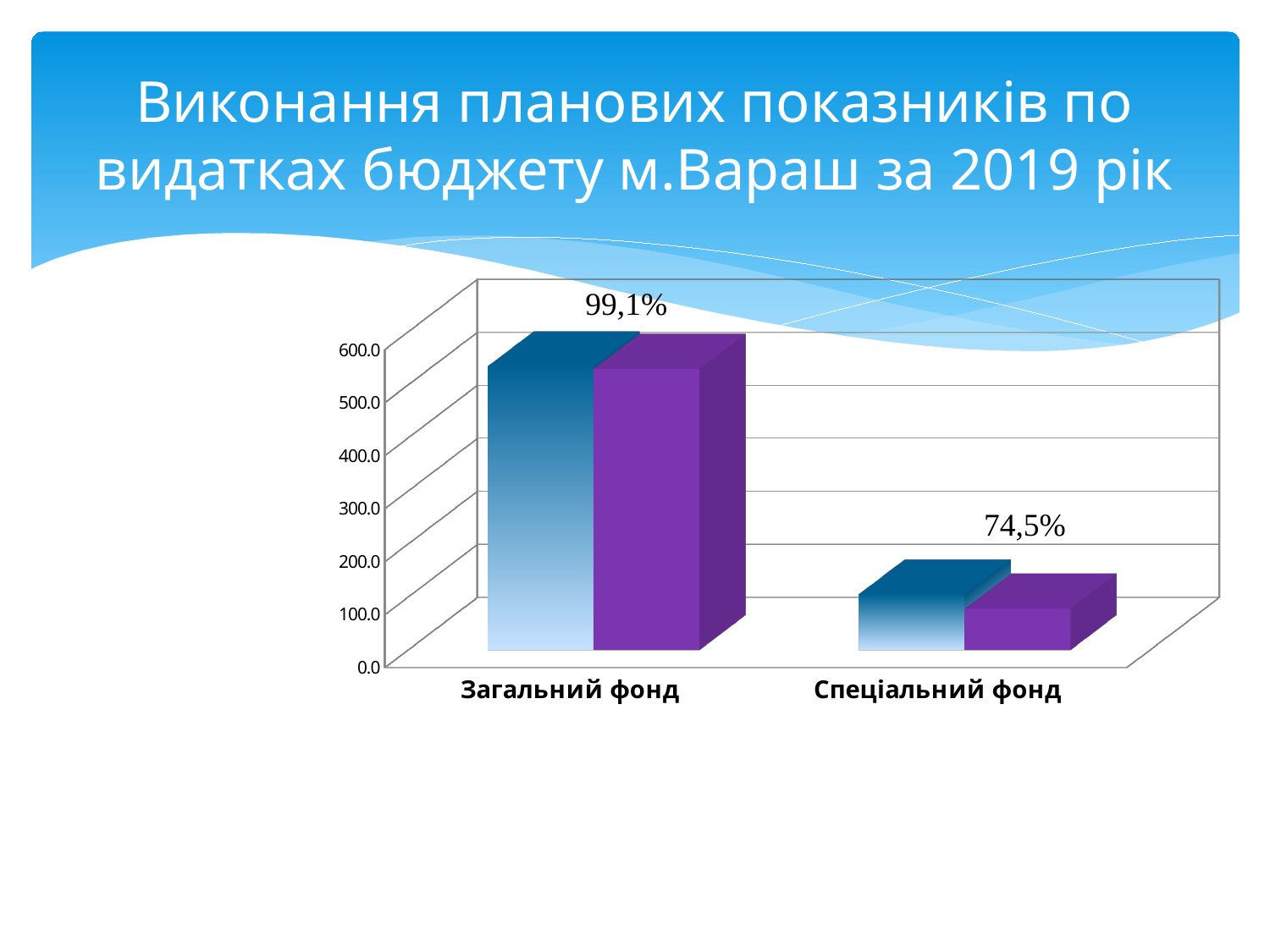
How many categories are shown on the x axis of the chart? 2 What percentage label is printed above the bars for Спеціальний фонд? 74,5% Which category has the highest bars in the chart? Загальний фонд Do the bar values rise or fall from Загальний фонд to Спеціальний фонд? fall What percentage label is printed above the bars for Загальний фонд? 99,1% Is the value of the purple bar for Спеціальний фонд greater or less than 300? less Is the value of the blue bar for Спеціальний фонд greater or less than 300? less Which category has the lowest bars in the chart? Спеціальний фонд What kind of chart is shown on the slide? bar chart Which category has the larger blue bar, Загальний фонд or Спеціальний фонд? Загальний фонд Is the value of the blue bar for Загальний фонд greater or less than 500? greater